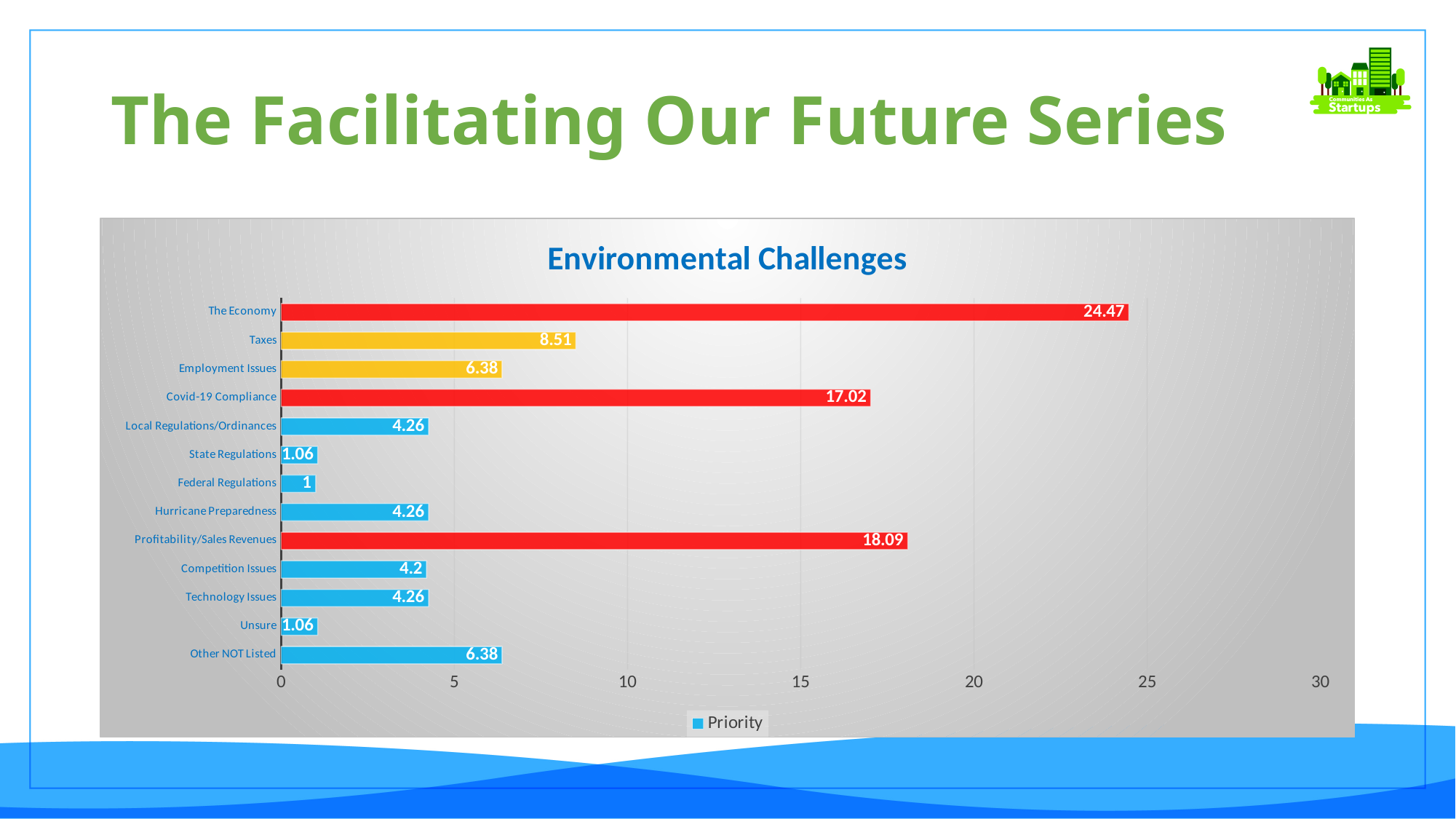
What is the difference between the values for The Economy and Covid-19 Compliance? 7.45 What is the value for The Economy in the Environmental Challenges chart? 24.47 What type of chart is the Environmental Challenges chart? Bar chart Which category has the lowest value in the Environmental Challenges chart? Federal Regulations Which category has the highest value in the Environmental Challenges chart? The Economy Which is larger, the value for Profitability/Sales Revenues or the value for Covid-19 Compliance? Profitability/Sales Revenues How many categories are shown in the Environmental Challenges chart? 13 What is the value for Profitability/Sales Revenues in the Environmental Challenges chart? 18.09 What is the value for Covid-19 Compliance in the Environmental Challenges chart? 17.02 What is the value for Taxes in the Environmental Challenges chart? 8.51 How many series does the legend of the Environmental Challenges chart list? 1 What is the difference between the values for Taxes and Employment Issues? 2.13